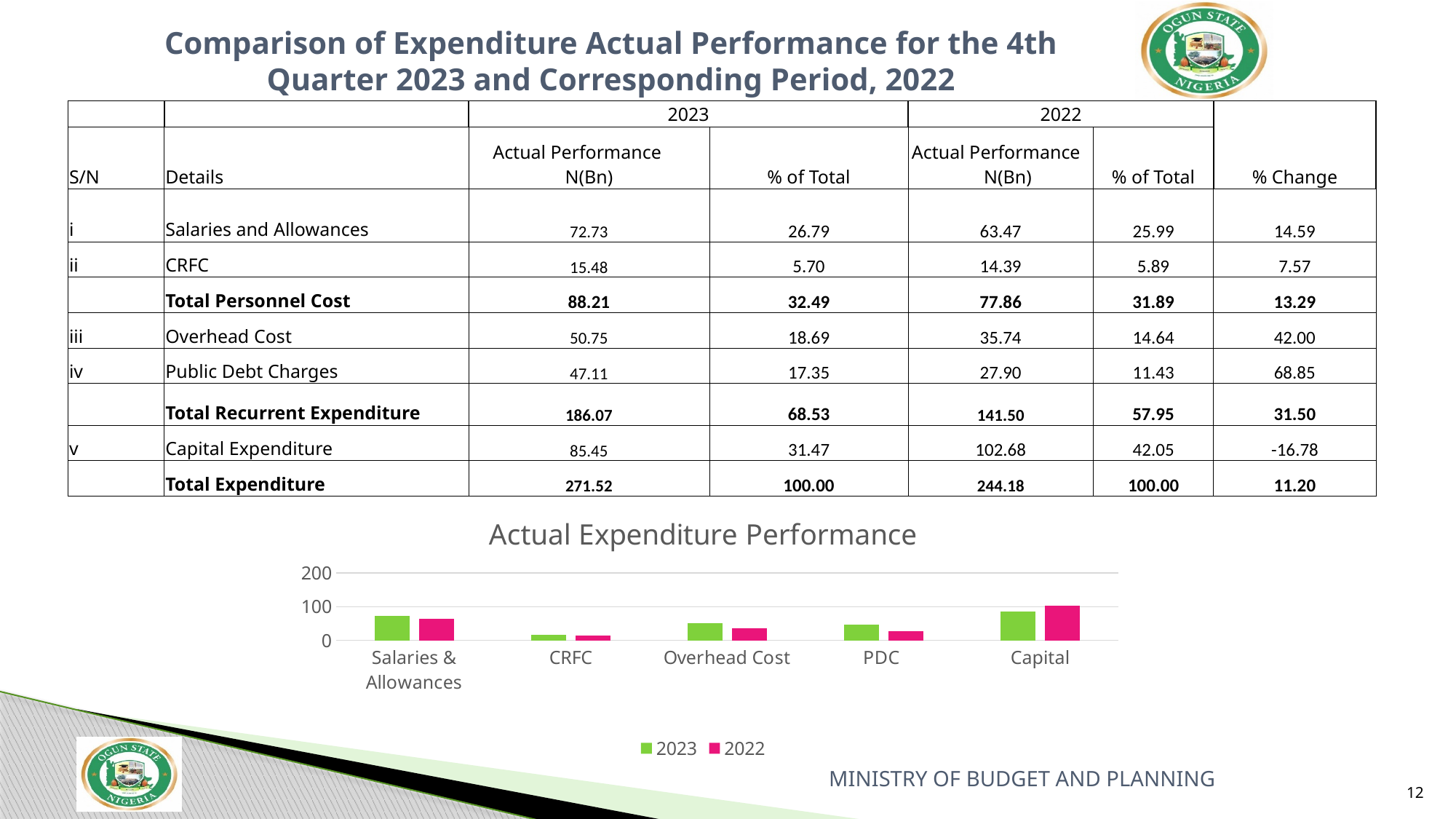
In the 'Actual Expenditure Performance' chart, what colour are the bars for the 2022 series? pink In the 'Actual Expenditure Performance' chart, which category has the shortest 2023 bar? CRFC How many series does the legend of the 'Actual Expenditure Performance' chart list? 2 In the 'Actual Expenditure Performance' chart, is the 2023 bar for PDC larger or smaller than the 2022 bar for PDC? larger In the 'Actual Expenditure Performance' chart, is the 2023 value for Salaries & Allowances greater or less than 100? less How many categories are shown on the x axis of the 'Actual Expenditure Performance' chart? 5 In the 'Actual Expenditure Performance' chart, which category has the shortest 2022 bar? CRFC In the 'Actual Expenditure Performance' chart, is the 2022 value for Overhead Cost greater or less than 100? less What type of chart is shown under the title 'Actual Expenditure Performance'? bar chart In the 'Actual Expenditure Performance' chart, is the 2023 bar for Overhead Cost larger or smaller than the 2022 bar for Overhead Cost? larger In the 'Actual Expenditure Performance' chart, which category has the tallest 2022 bar? Capital In the 'Actual Expenditure Performance' chart, is the 2023 bar for Capital larger or smaller than the 2022 bar for Capital? smaller